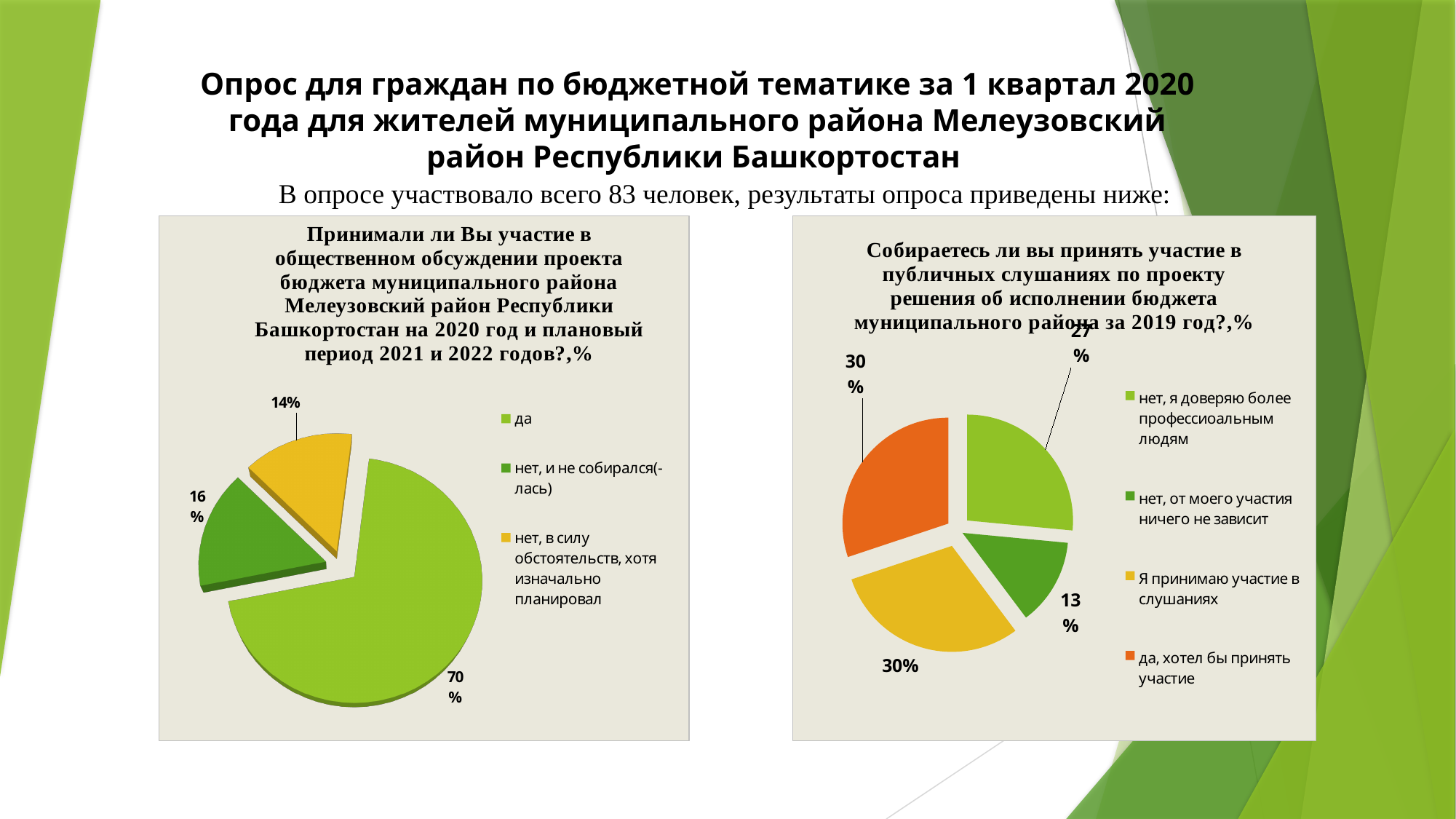
In the left pie chart, what share of respondents answered "да"? 70% What kind of chart is the left chart on the slide? pie chart In the right pie chart, which is larger: the share for "да, хотел бы принять участие" or the share for "нет, от моего участия ничего не зависит"? да, хотел бы принять участие In the right pie chart, how many categories does the legend list? 4 In the left pie chart, what is the difference between the share for "да" and the share for "нет, и не собирался(-лась)"? 54% In the right pie chart, what share of respondents answered "нет, я доверяю более профессиоальным людям"? 27% In the left pie chart, which answer has the smallest share? нет, в силу обстоятельств, хотя изначально планировал In the left pie chart, how many slices does the pie have? 3 In the right pie chart, which answer has the smallest share? нет, от моего участия ничего не зависит In the left pie chart, what share of respondents answered "нет, и не собирался(-лась)"? 16% In the right pie chart, what share of respondents answered "нет, от моего участия ничего не зависит"? 13% In the right pie chart, what colour is the slice for "да, хотел бы принять участие"? orange